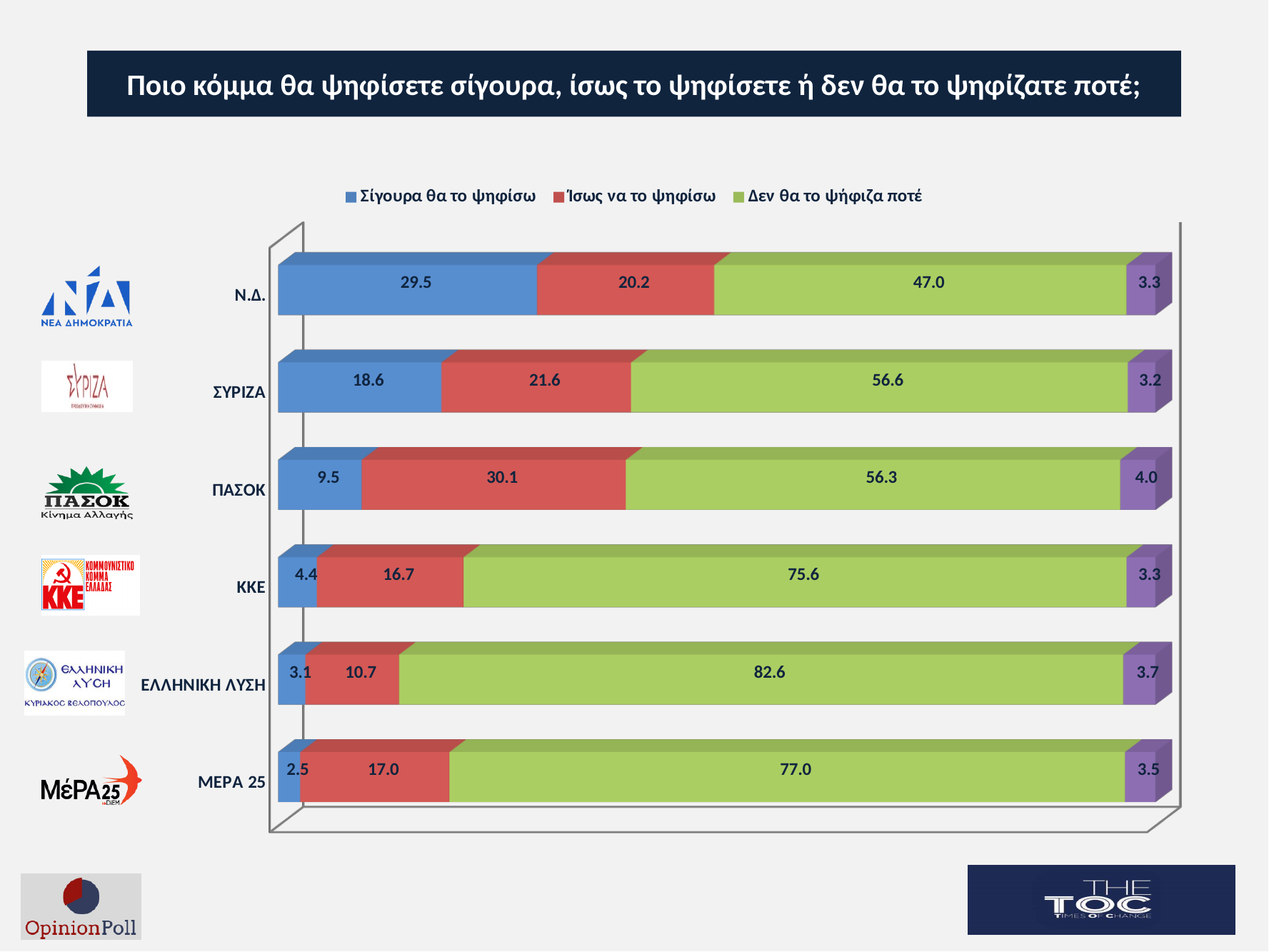
Which is larger: the 'Ίσως να το ψηφίσω' value for ΣΥΡΙΖΑ or for ΚΚΕ? ΣΥΡΙΖΑ How many parties (categories) are shown in the chart? 6 What is the total of the stacked bar for Ν.Δ.? 100.0 What is the value of 'Σίγουρα θα το ψηφίσω' for Ν.Δ.? 29.5 What is the difference between the 'Δεν θα το ψήφιζα ποτέ' values for ΣΥΡΙΖΑ and Ν.Δ.? 9.6 How many series does the legend list? 3 Which party has the lowest value for 'Σίγουρα θα το ψηφίσω'? ΜΕΡΑ 25 What is the value of 'Ίσως να το ψηφίσω' for ΠΑΣΟΚ? 30.1 Which party has the highest value for 'Σίγουρα θα το ψηφίσω'? Ν.Δ. What kind of chart is shown on the slide? Stacked bar chart What is the value of 'Δεν θα το ψήφιζα ποτέ' for ΕΛΛΗΝΙΚΗ ΛΥΣΗ? 82.6 Which party has the lowest value for 'Δεν θα το ψήφιζα ποτέ'? Ν.Δ.